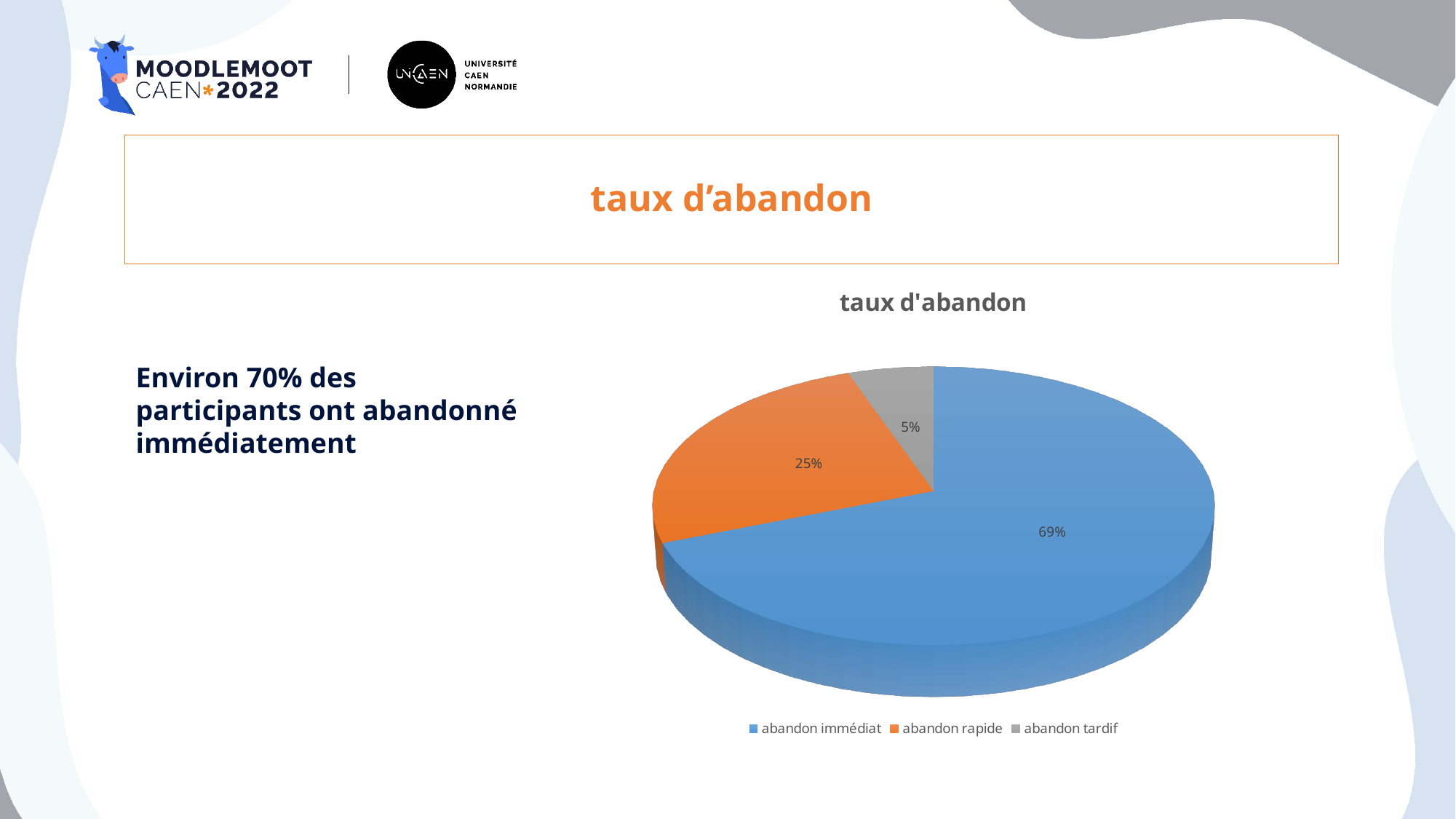
How many categories does the pie chart show? 3 What kind of chart is shown on the slide? pie chart Which category has the largest slice of the pie? abandon immédiat What share of the pie does 'abandon tardif' represent? 5% Which is larger, the slice for 'abandon rapide' or the slice for 'abandon tardif'? abandon rapide Which category has the smallest slice of the pie? abandon tardif What is the difference in percentage points between 'abandon immédiat' and 'abandon rapide'? 44 What share of the pie does 'abandon immédiat' represent? 69% Which colour represents 'abandon rapide' in the legend? orange What is the title of the chart? taux d'abandon What is the difference in percentage points between 'abandon rapide' and 'abandon tardif'? 20 What share of the pie does 'abandon rapide' represent? 25%